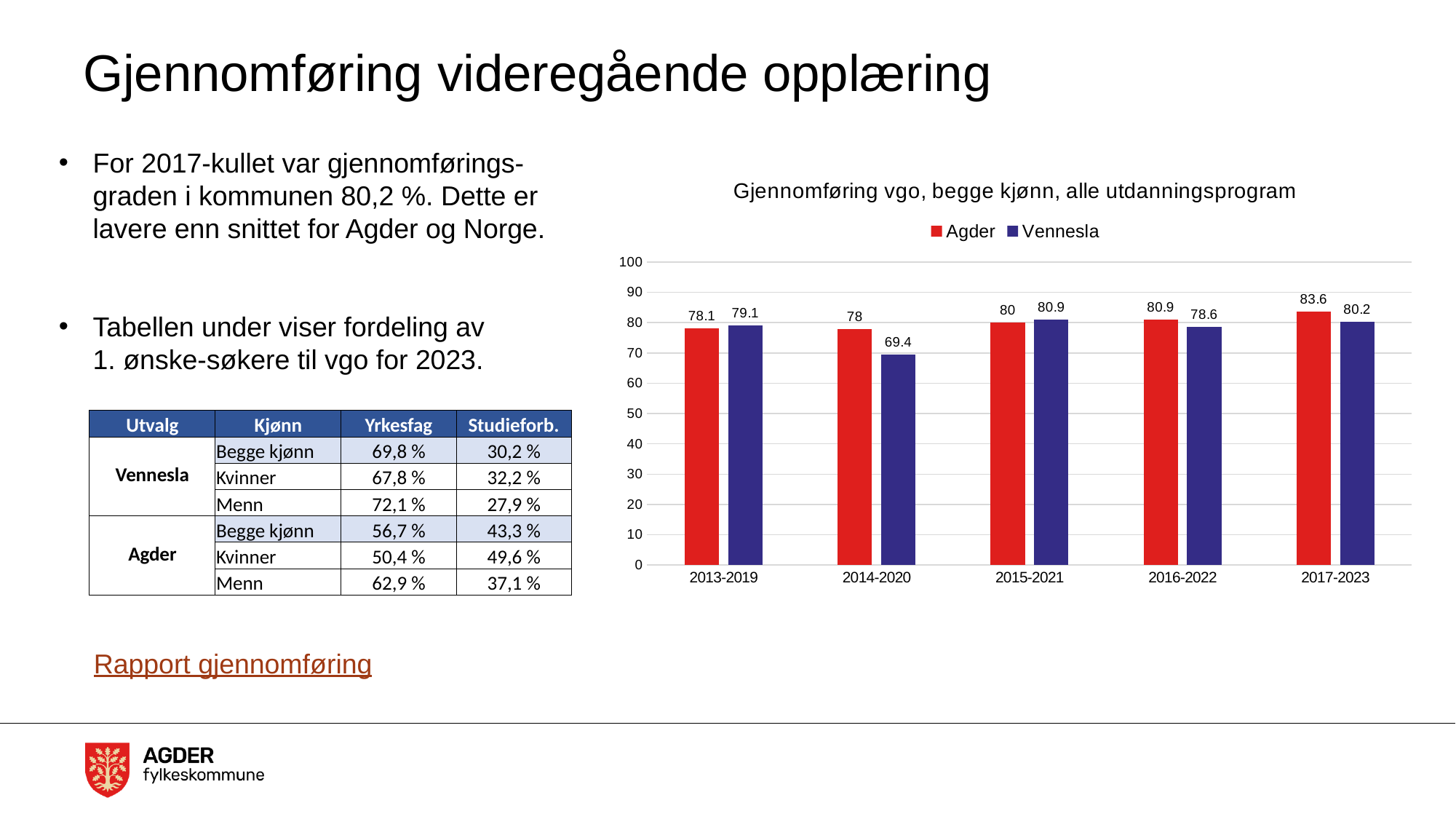
How many periods are shown on the x axis? 5 What is the value for Agder in 2017-2023? 83.6 What is the difference between the Agder and Vennesla values in 2014-2020? 8.6 What kind of chart is shown on the slide? bar chart What is the value for Agder in 2013-2019? 78.1 What is the value for Vennesla in 2015-2021? 80.9 Which is larger in 2016-2022, the Agder value or the Vennesla value? Agder In which period is the Vennesla value lowest? 2014-2020 How many series does the legend list? 2 In which period is the Agder value highest? 2017-2023 Is the value for Vennesla in 2014-2020 greater or less than 70? less What is the value for Vennesla in 2014-2020? 69.4